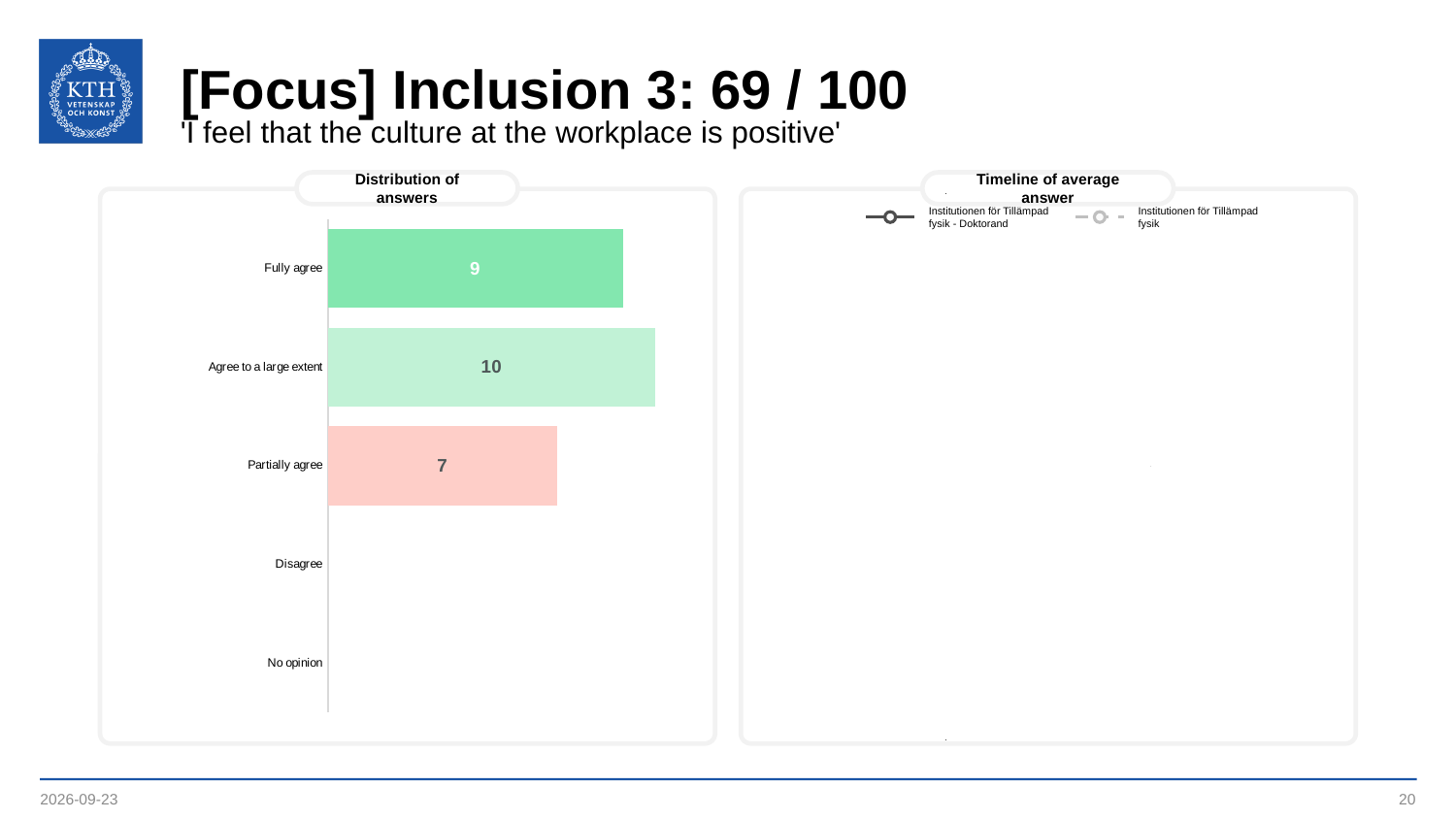
In the 'Distribution of answers' chart, which answer category has the highest value? Agree to a large extent In the 'Distribution of answers' chart, what is the value for 'Partially agree'? 7 In the 'Distribution of answers' chart, what is the total of the three labelled bars? 26 What kind of chart is the 'Distribution of answers' chart? Bar chart In the 'Distribution of answers' chart, what colour is the 'Partially agree' bar? Light red (pink) In the 'Distribution of answers' chart, how many respondents chose 'Fully agree'? 9 In the 'Distribution of answers' chart, which is larger: the value for 'Fully agree' or the value for 'Partially agree'? Fully agree In the 'Distribution of answers' chart, which of the three labelled bars has the lowest value? Partially agree In the 'Distribution of answers' chart, what is the difference between the values for 'Agree to a large extent' and 'Partially agree'? 3 In the 'Distribution of answers' chart, how many answer categories are listed on the axis? 5 In the 'Distribution of answers' chart, what is the value for 'Agree to a large extent'? 10 How many series does the legend of the 'Timeline of average answer' chart list? 2